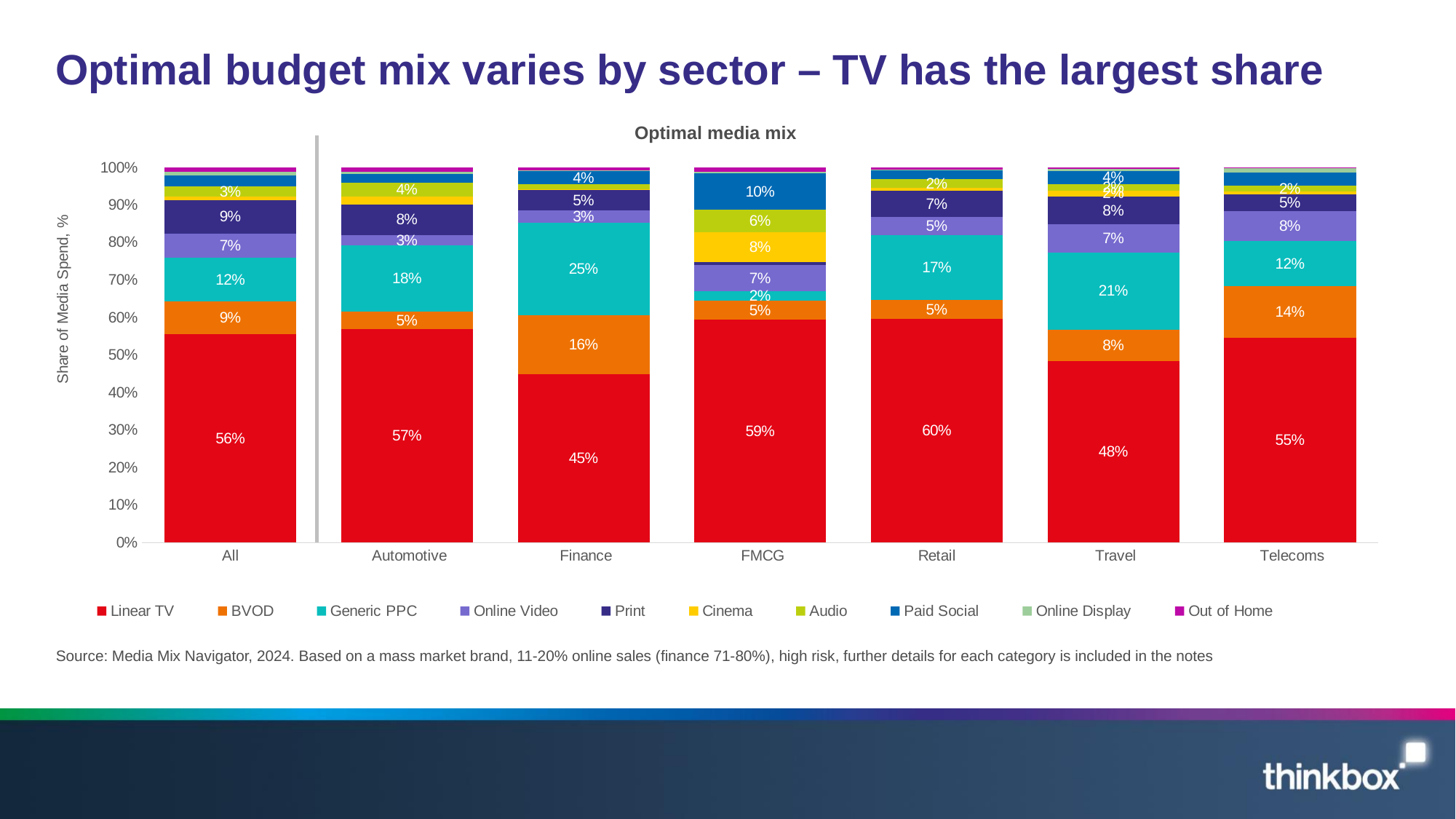
What is the Cinema share for the FMCG sector? 8% Which sector has the lowest Linear TV share? Finance What kind of chart is shown on the slide? Stacked bar chart What is the Generic PPC share for the Travel sector? 21% Which sector has the highest Linear TV share? Retail What is the difference between the Generic PPC share for Finance and for Automotive? 7% What is the Linear TV share for the Finance sector? 45% What is the BVOD share for the Telecoms sector? 14% Which is larger, the BVOD share for Finance or the BVOD share for Telecoms? Finance What is the Paid Social share for the FMCG sector? 10% How many sectors are shown on the x axis? 7 How many series does the legend list? 10